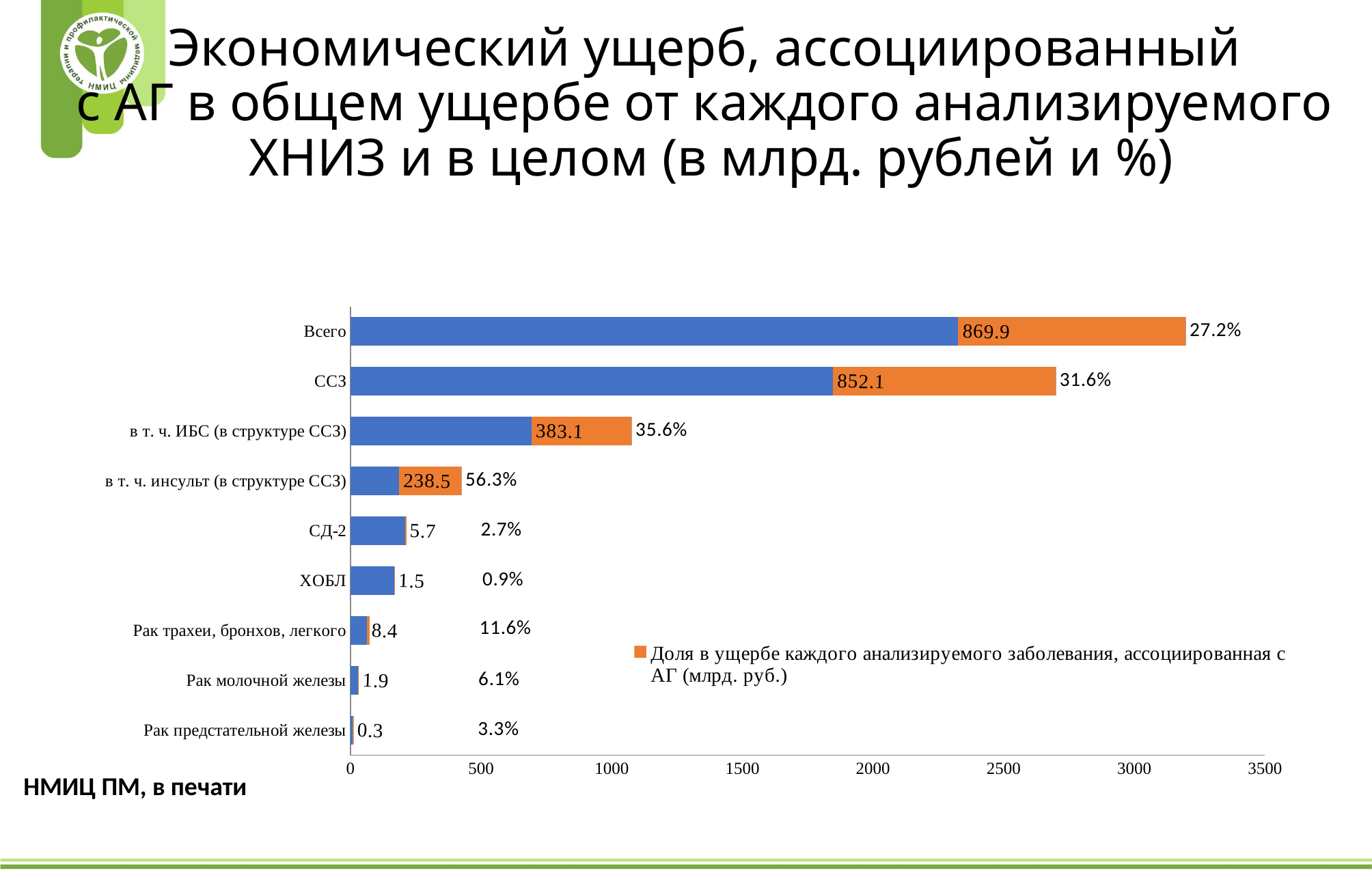
Which has a larger labelled orange-segment value: "в т. ч. ИБС (в структуре ССЗ)" or "в т. ч. инсульт (в структуре ССЗ)"? в т. ч. ИБС (в структуре ССЗ) What is the difference between the labelled orange-segment values for "Всего" and "ССЗ"? 17.8 Which category has the lowest labelled orange-segment value? Рак предстательной железы Is the total length of the bar for "в т. ч. инсульт (в структуре ССЗ)" greater or less than 500? less How many categories are shown on the vertical axis of the chart? 9 What percentage is shown next to the bar for "Рак трахеи, бронхов, легкого"? 11.6% What kind of chart is shown on the slide? Bar chart What is the labelled value of the orange segment for "ССЗ"? 852.1 What is the labelled value of the orange segment for "Всего"? 869.9 Which category has the highest labelled orange-segment value? Всего What percentage is shown next to the bar for "в т. ч. инсульт (в структуре ССЗ)"? 56.3% Is the total length of the bar for "Всего" greater or less than 3000? greater